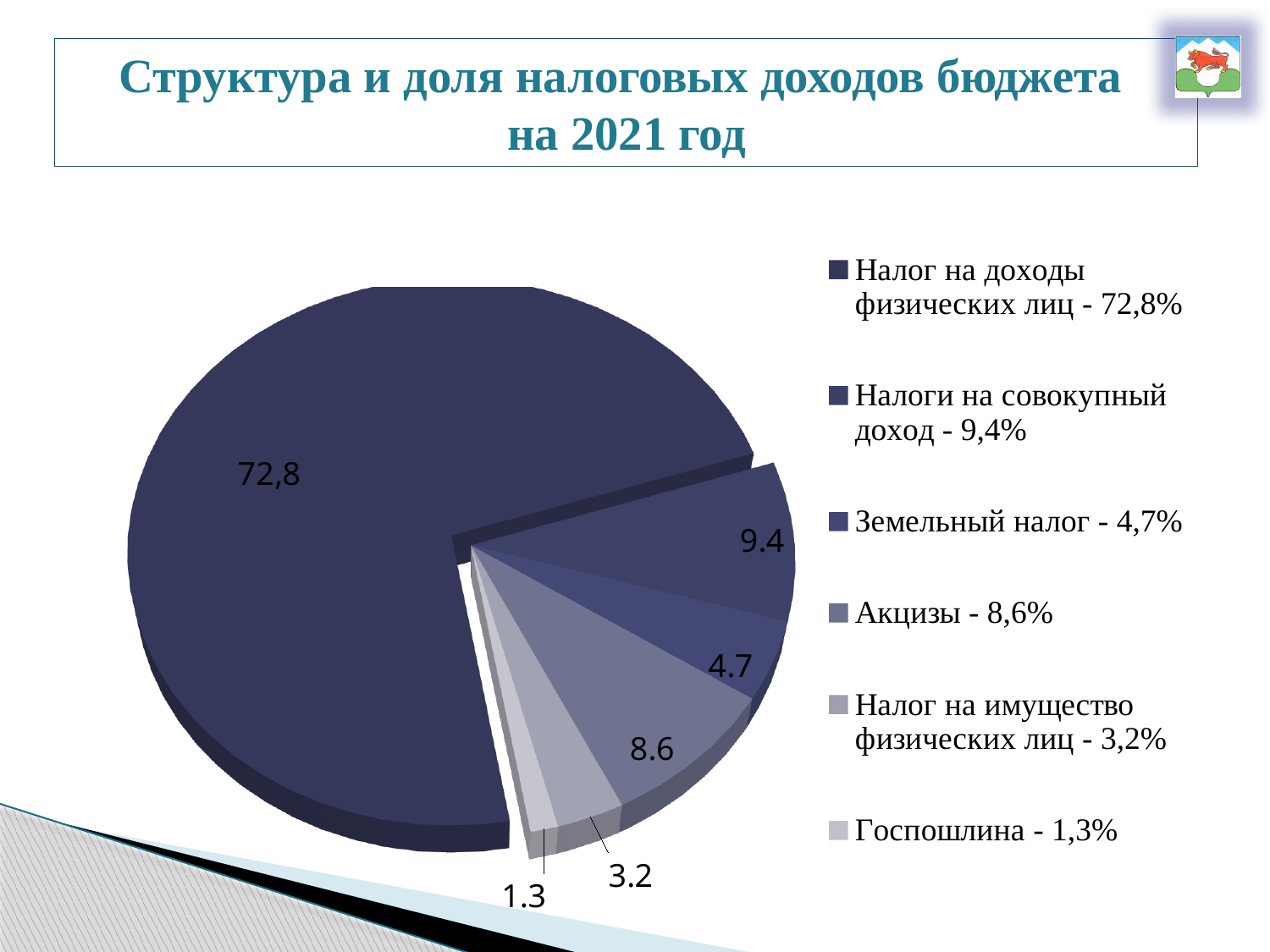
What is the value shown for Налоги на совокупный доход? 9.4 Which category has the smallest slice of the pie? Госпошлина What is the value shown for Акцизы? 8.6 What is the value shown for Госпошлина? 1.3 Which is larger, the slice for Налоги на совокупный доход or the slice for Акцизы? Налоги на совокупный доход What is the difference between the values for Налоги на совокупный доход and Земельный налог? 4.7 Which category has the largest slice of the pie? Налог на доходы физических лиц How many slices does the pie chart have? 6 What is the value shown for Земельный налог? 4.7 What kind of chart is shown on the slide? Pie chart What is the title of the slide? Структура и доля налоговых доходов бюджета на 2021 год What is the value shown for Налог на доходы физических лиц? 72,8